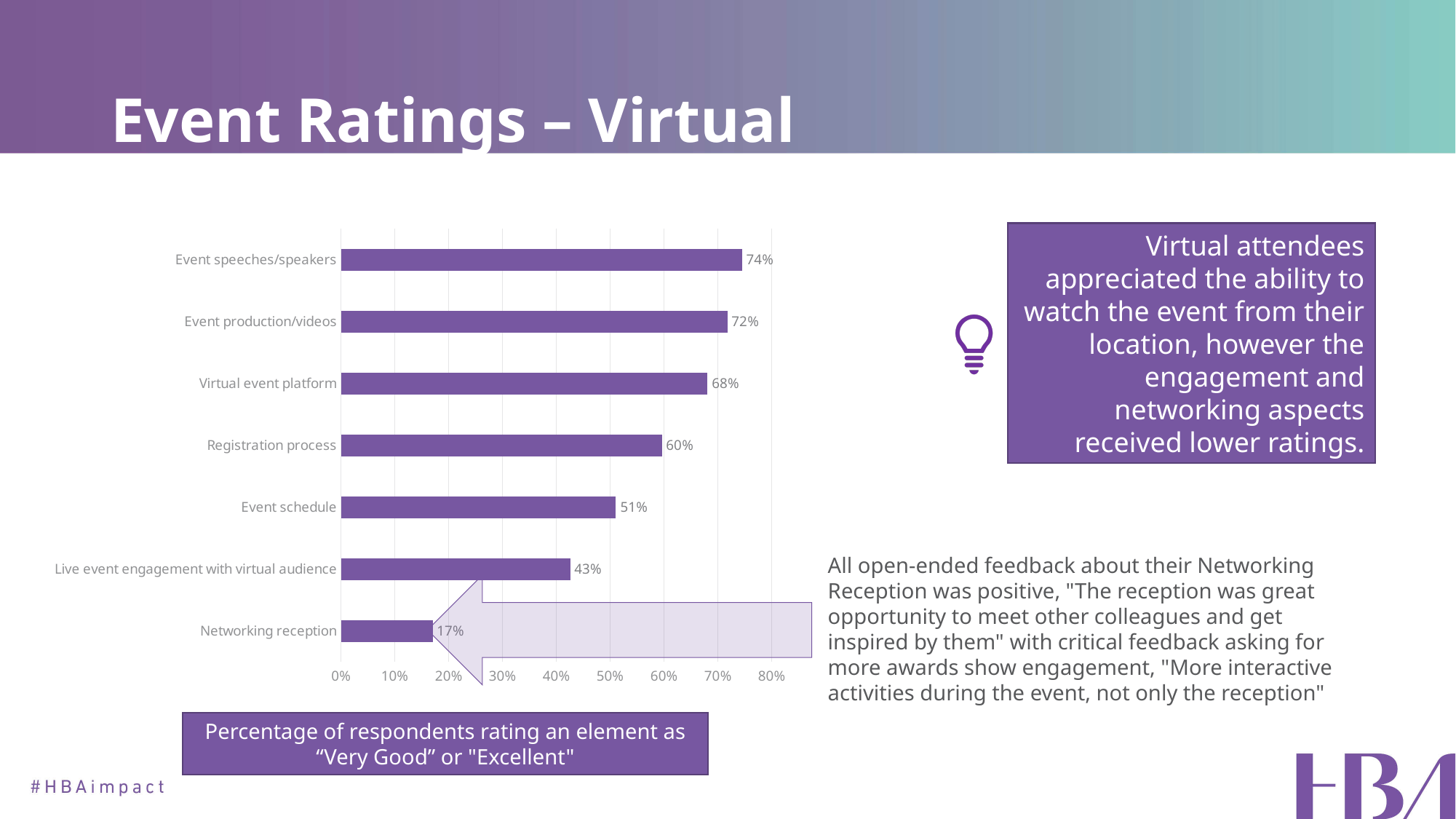
What is the difference between the highest and lowest values in the chart? 57% What is the value shown for Virtual event platform? 68% Which element received the lowest rating? Networking reception What kind of chart is shown on the slide? Bar chart How many elements are rated in the chart? 7 Which has a higher value, Event schedule or Live event engagement with virtual audience? Event schedule Which element received the highest rating? Event speeches/speakers What is the highest value shown on the x axis? 80% What is the difference between the values for Event production/videos and Registration process? 12% What percentage of respondents rated Event speeches/speakers as "Very Good" or "Excellent"? 74% Is the value for Registration process greater or less than 50%? greater What is the value shown for Live event engagement with virtual audience? 43%